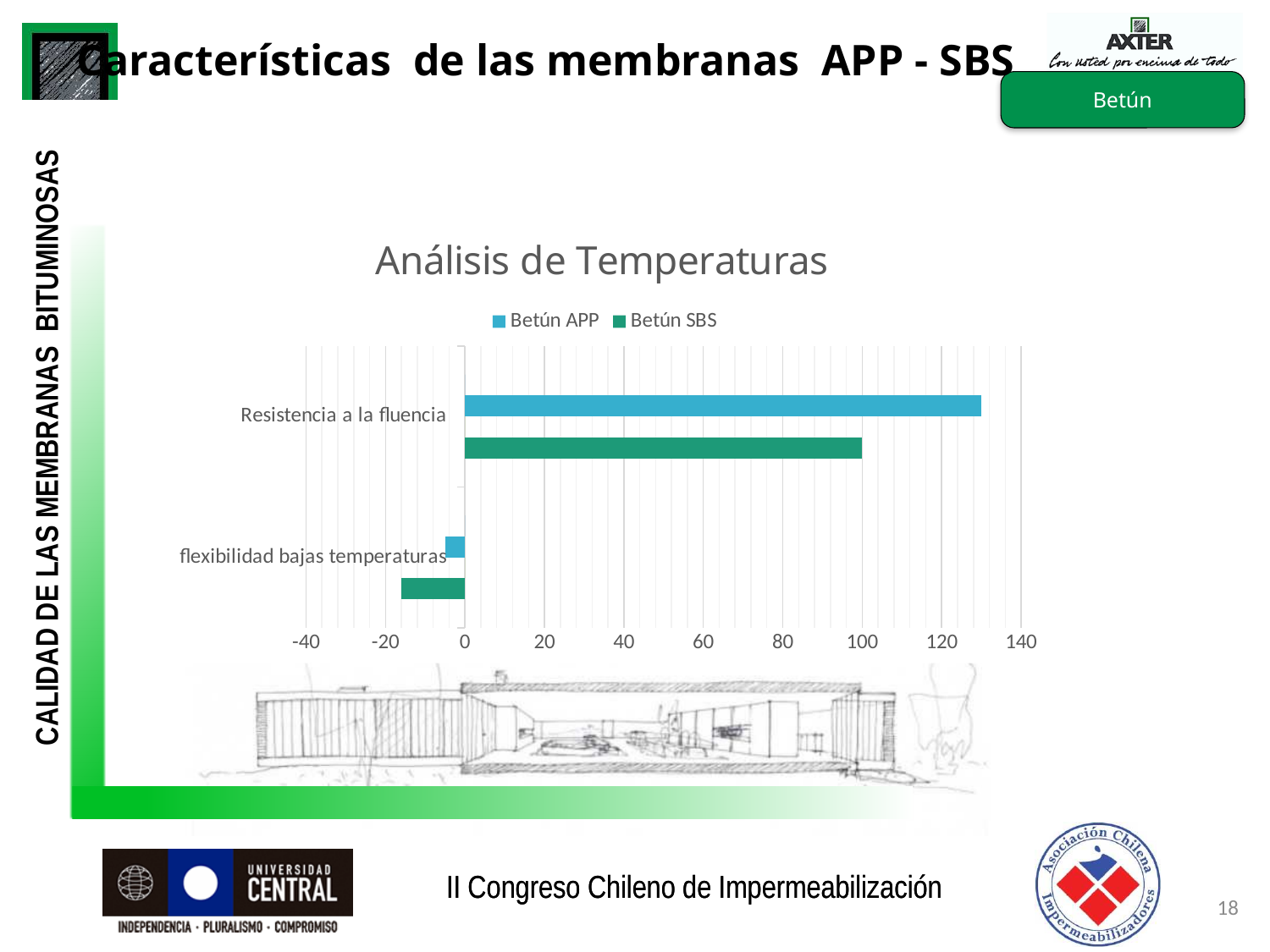
Is the value of Betún APP for 'Resistencia a la fluencia' greater or less than 120? greater What is the title of the chart on the slide? Análisis de Temperaturas Is the value of Betún SBS for 'flexibilidad bajas temperaturas' greater or less than 0? less For 'flexibilidad bajas temperaturas', which series has the lower value, Betún APP or Betún SBS? Betún SBS What type of chart is shown under the title 'Análisis de Temperaturas'? bar chart For 'Resistencia a la fluencia', which series has the larger value, Betún APP or Betún SBS? Betún APP What is the value of Betún SBS for 'Resistencia a la fluencia'? 100 What are the two series named in the legend of the 'Análisis de Temperaturas' chart? Betún APP and Betún SBS Is the value of Betún APP for 'flexibilidad bajas temperaturas' greater or less than -20? greater Which category has the highest value for Betún APP in the 'Análisis de Temperaturas' chart? Resistencia a la fluencia How many categories are shown on the vertical axis of the 'Análisis de Temperaturas' chart? 2 How many series does the legend of the 'Análisis de Temperaturas' chart list? 2